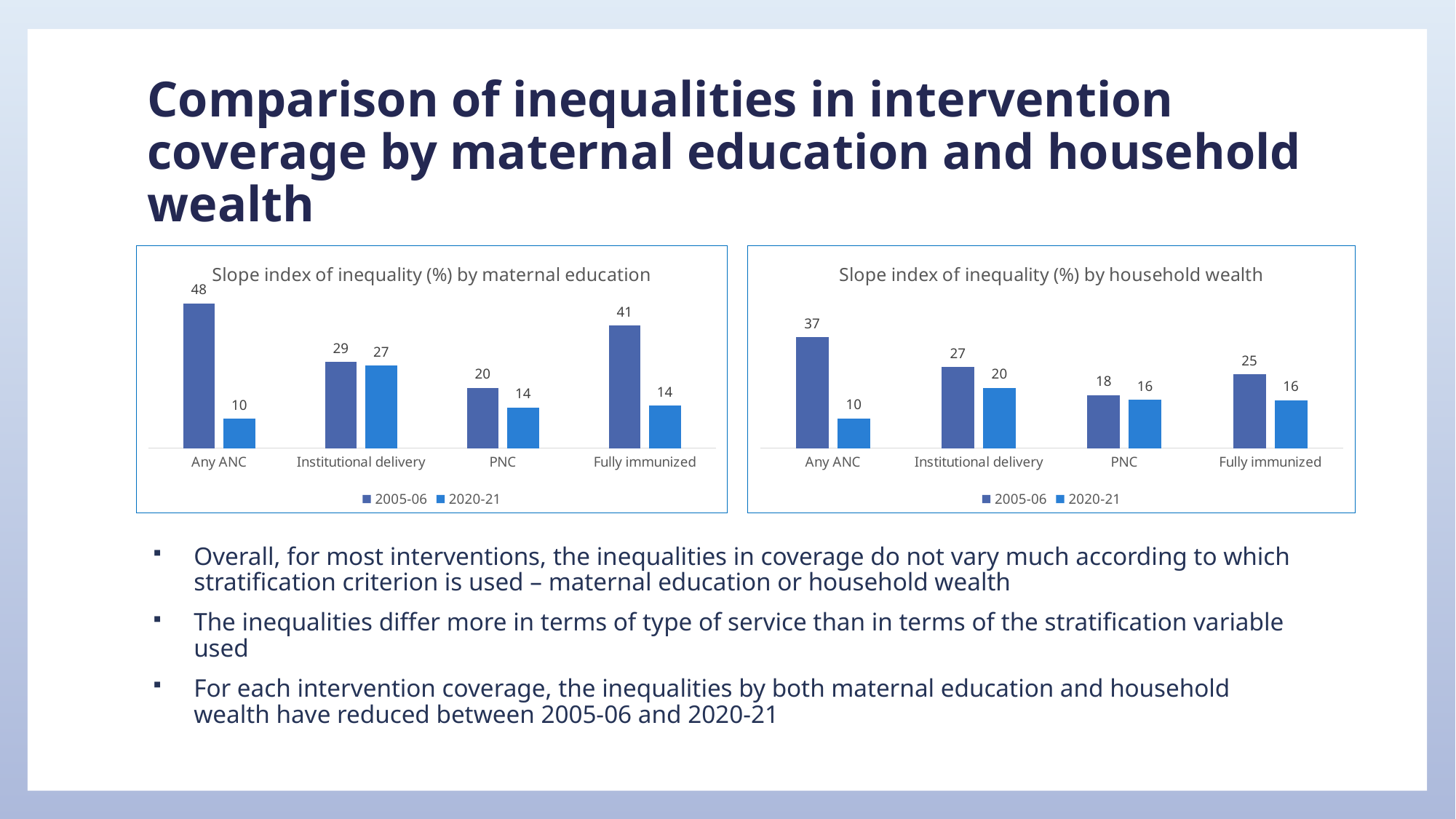
In the 'Slope index of inequality (%) by maternal education' chart, what is the value for PNC in 2020-21? 14 In the 'Slope index of inequality (%) by household wealth' chart, which is larger for PNC: the 2005-06 value or the 2020-21 value? 2005-06 In the 'Slope index of inequality (%) by household wealth' chart, which category has the lowest value for 2020-21? Any ANC How many series does the legend of the 'Slope index of inequality (%) by household wealth' chart list? 2 In the 'Slope index of inequality (%) by maternal education' chart, what is the value for Any ANC in 2005-06? 48 In the 'Slope index of inequality (%) by household wealth' chart, what is the value for Institutional delivery in 2020-21? 20 What type of chart is the 'Slope index of inequality (%) by maternal education' chart? Bar chart In the 'Slope index of inequality (%) by maternal education' chart, what is the difference between the 2005-06 and 2020-21 values for Fully immunized? 27 How many categories are shown on the x axis of the 'Slope index of inequality (%) by maternal education' chart? 4 In the 'Slope index of inequality (%) by maternal education' chart, which category has the highest value for 2005-06? Any ANC In the 'Slope index of inequality (%) by household wealth' chart, what is the difference between the 2005-06 and 2020-21 values for Any ANC? 27 What are the two series listed in the legend of the 'Slope index of inequality (%) by maternal education' chart? 2005-06 and 2020-21